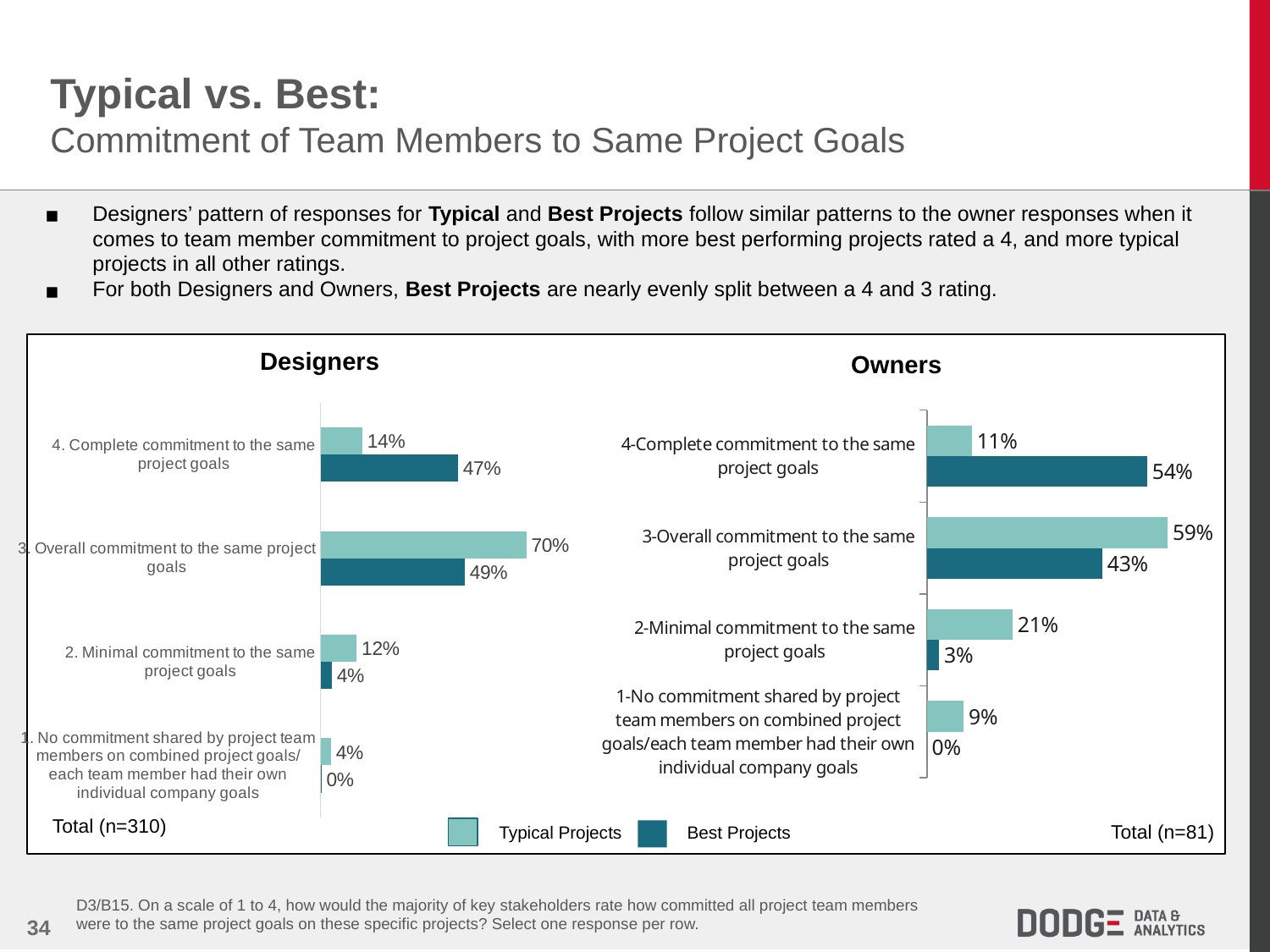
In the Owners chart, which rating category has the lowest value for Best Projects? 1-No commitment shared by project team members on combined project goals/each team member had their own individual company goals In the Designers chart, which is larger for rating 2 (Minimal commitment): Typical Projects or Best Projects? Typical Projects In the Owners chart, what percentage of Best Projects were rated 4 (Complete commitment to the same project goals)? 54% In the Owners chart, what percentage of Typical Projects were rated 2 (Minimal commitment to the same project goals)? 21% What type of chart is the Designers chart? Bar chart In the Designers chart, what percentage of Best Projects were rated 4 (Complete commitment to the same project goals)? 47% In the Designers chart, what is the difference between the Best Projects and Typical Projects values for rating 4 (Complete commitment)? 33% How many series does the legend list for the charts? 2 How many rating categories are shown in the Owners chart? 4 In the Designers chart, which rating category has the highest value for Typical Projects? 3. Overall commitment to the same project goals In the Designers chart, what percentage of Typical Projects were rated 3 (Overall commitment to the same project goals)? 70% In the Owners chart, what is the difference between the Typical Projects and Best Projects values for rating 3 (Overall commitment)? 16%